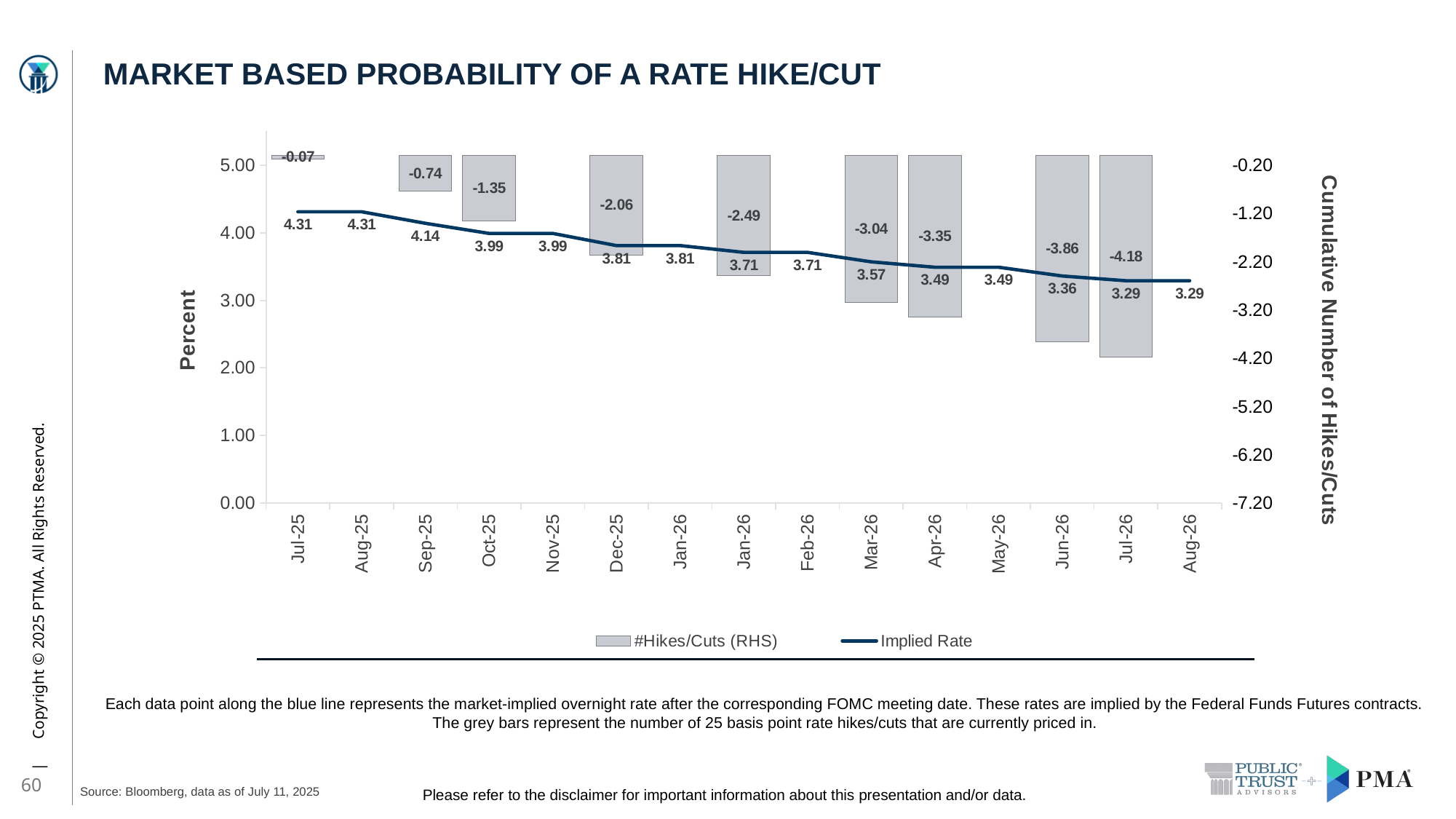
Which month has the lowest (most negative) #Hikes/Cuts (RHS) value? Jul-26 What is the Implied Rate value shown for Oct-25? 3.99 Is the Implied Rate for Feb-26 greater or less than 4.00? less How many series does the legend list? 2 What is the #Hikes/Cuts (RHS) value shown for Mar-26? -3.04 What is the difference between the Implied Rate for Jul-25 and the Implied Rate for Aug-26? 1.02 What is the Implied Rate value shown for Aug-26? 3.29 Does the Implied Rate line rise or fall from Jul-25 to Aug-26? fall Which has a higher Implied Rate, Sep-25 or Mar-26? Sep-25 What is the #Hikes/Cuts (RHS) value shown for Dec-25? -2.06 How many categories are shown on the x axis? 15 What is the difference between the #Hikes/Cuts values for Jun-26 and Jul-26? 0.32